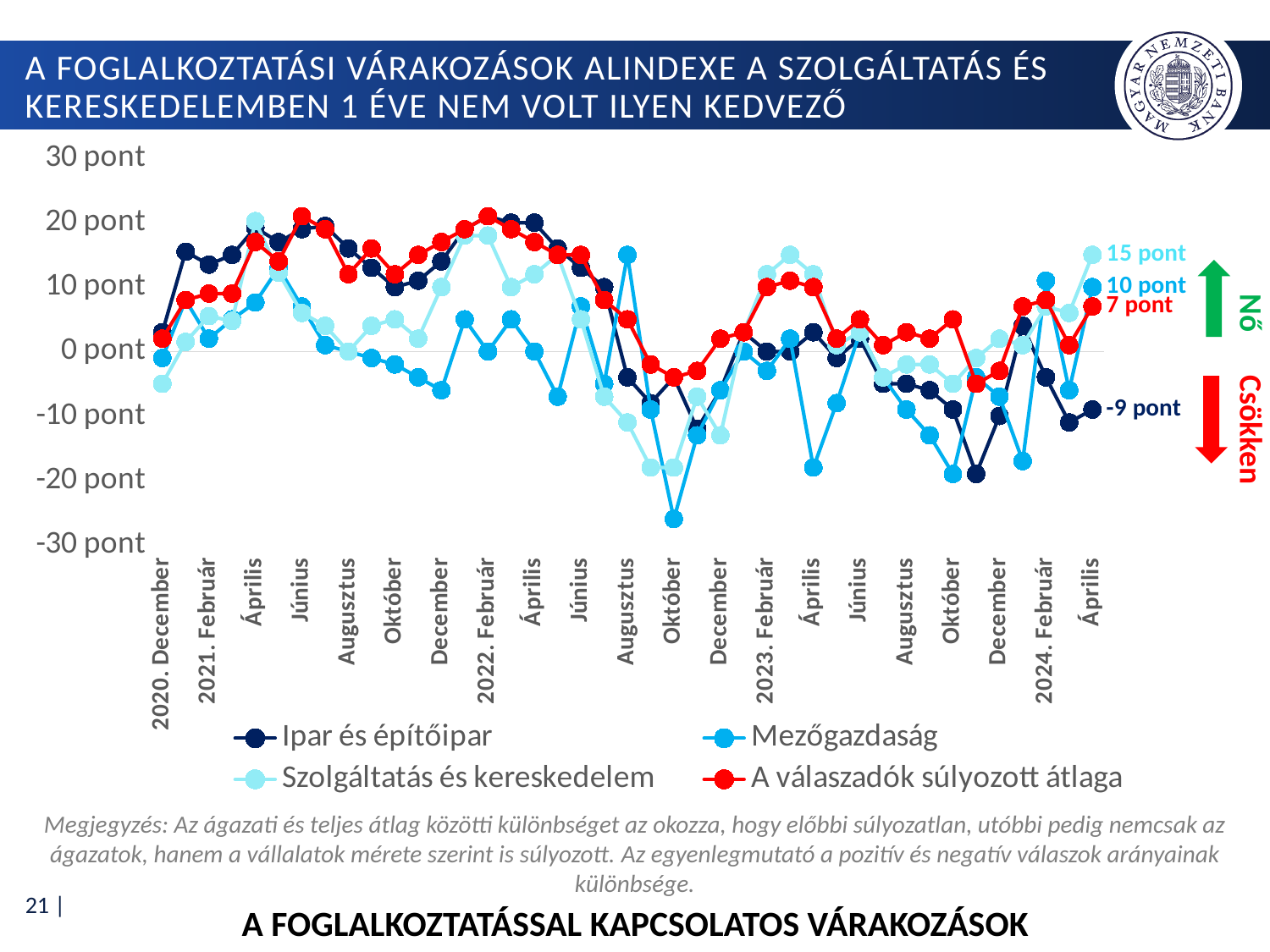
Which series has the highest value at the last point (2024 Április)? Szolgáltatás és kereskedelem How many series does the legend list? 4 What is the difference between the last values of Szolgáltatás és kereskedelem and Mezőgazdaság? 5 pont What is the value for Ipar és építőipar at the last point (2024 Április)? -9 pont Which series has the lowest value at the last point (2024 Április)? Ipar és építőipar At the last point, which is larger: Mezőgazdaság or A válaszadók súlyozott átlaga? Mezőgazdaság What is the difference between the last values of Szolgáltatás és kereskedelem and Ipar és építőipar? 24 pont What is the value for Szolgáltatás és kereskedelem at the last point (2024 Április)? 15 pont What is the value for Mezőgazdaság at the last point (2024 Április)? 10 pont What is the value for A válaszadók súlyozott átlaga at the last point (2024 Április)? 7 pont What kind of chart is shown on the slide? line chart Is the value for Mezőgazdaság in 2022 Október greater or less than -20 pont? less